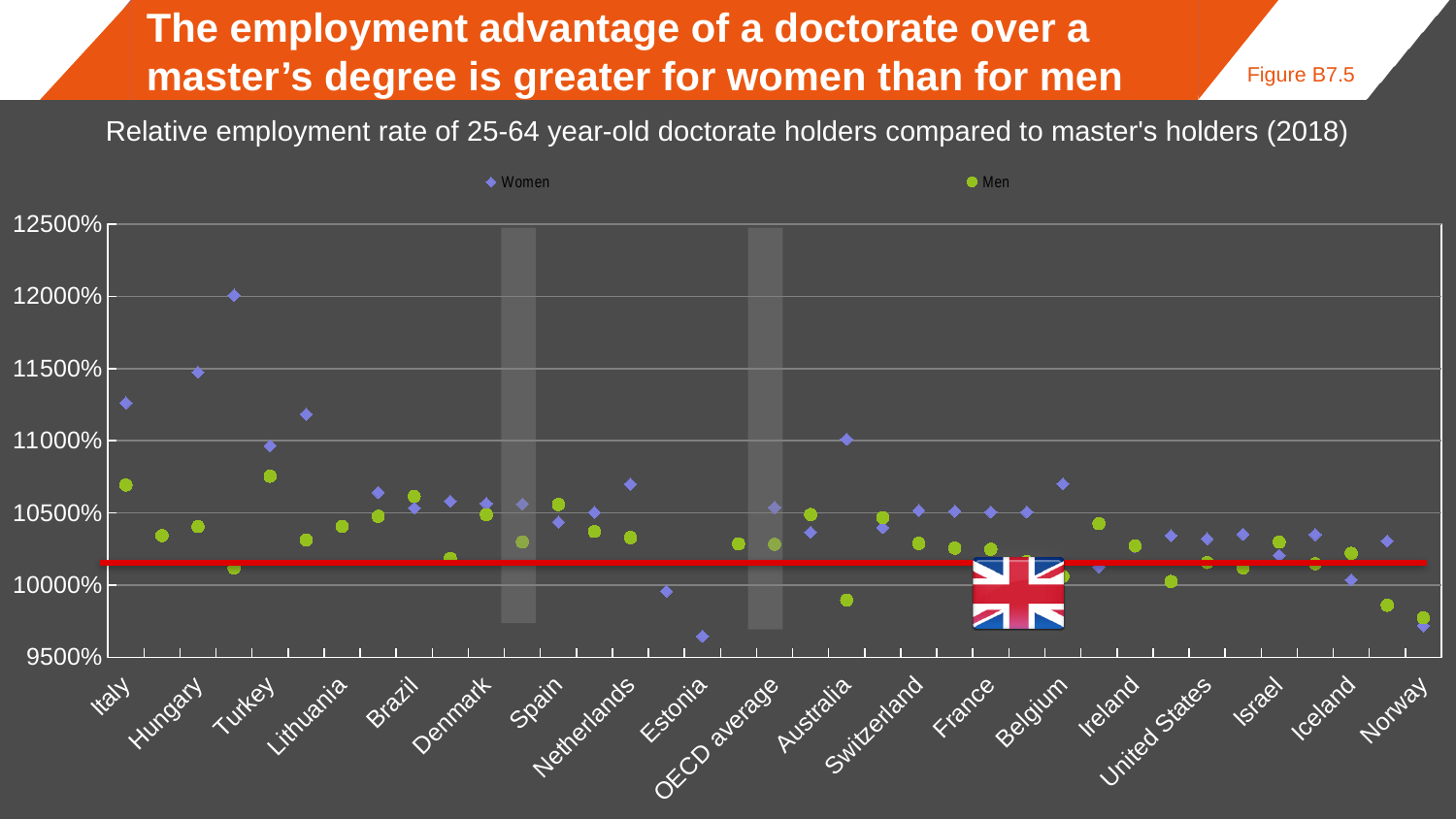
What is the figure number shown on the slide? Figure B7.5 Is the Men value for Italy greater or less than 10500%? greater What kind of chart is shown on the slide? Scatter chart How many series does the legend list? 2 What are the two series named in the legend? Women and Men Is the Women value for Italy greater or less than 11000%? greater Is the Men value for Switzerland greater or less than 10500%? less For Turkey, which is higher: the Women value or the Men value? Women